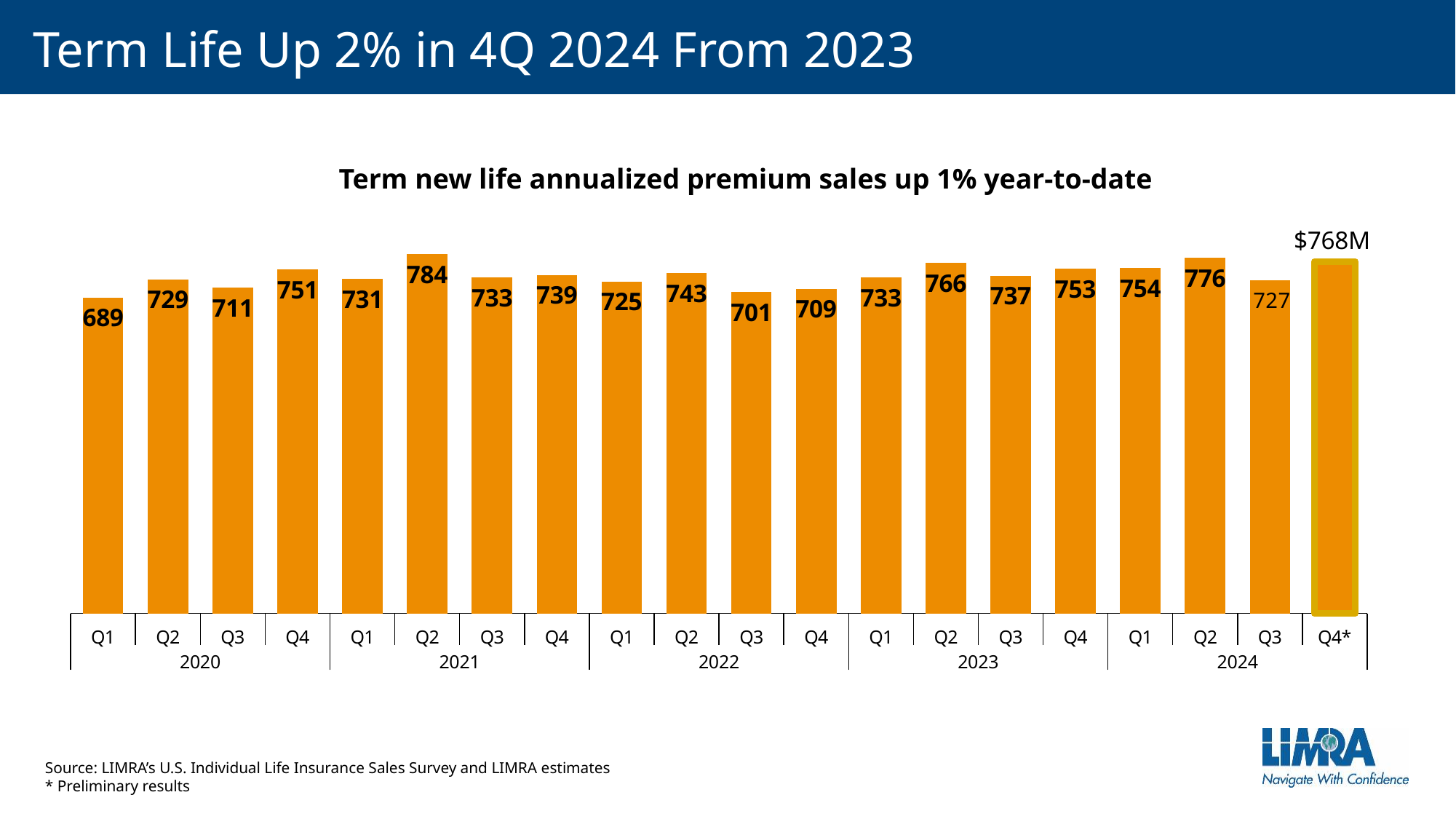
Which quarter has the highest value? Q2 2021 What is the value for Q3 2022? 701 What is the chart's title? Term new life annualized premium sales up 1% year-to-date Which quarter has the lowest value? Q1 2020 Which is larger, Q2 2024 or Q3 2024? Q2 2024 What kind of chart is shown? Bar chart What is the value for Q1 2020? 689 What is the value for Q2 2021? 784 What is the difference between Q2 2021 and Q1 2020? 95 How many quarterly bars are plotted on the chart? 20 What is the difference between Q4 2024 and Q4 2023? 15 What is the value for Q4 2024? $768M